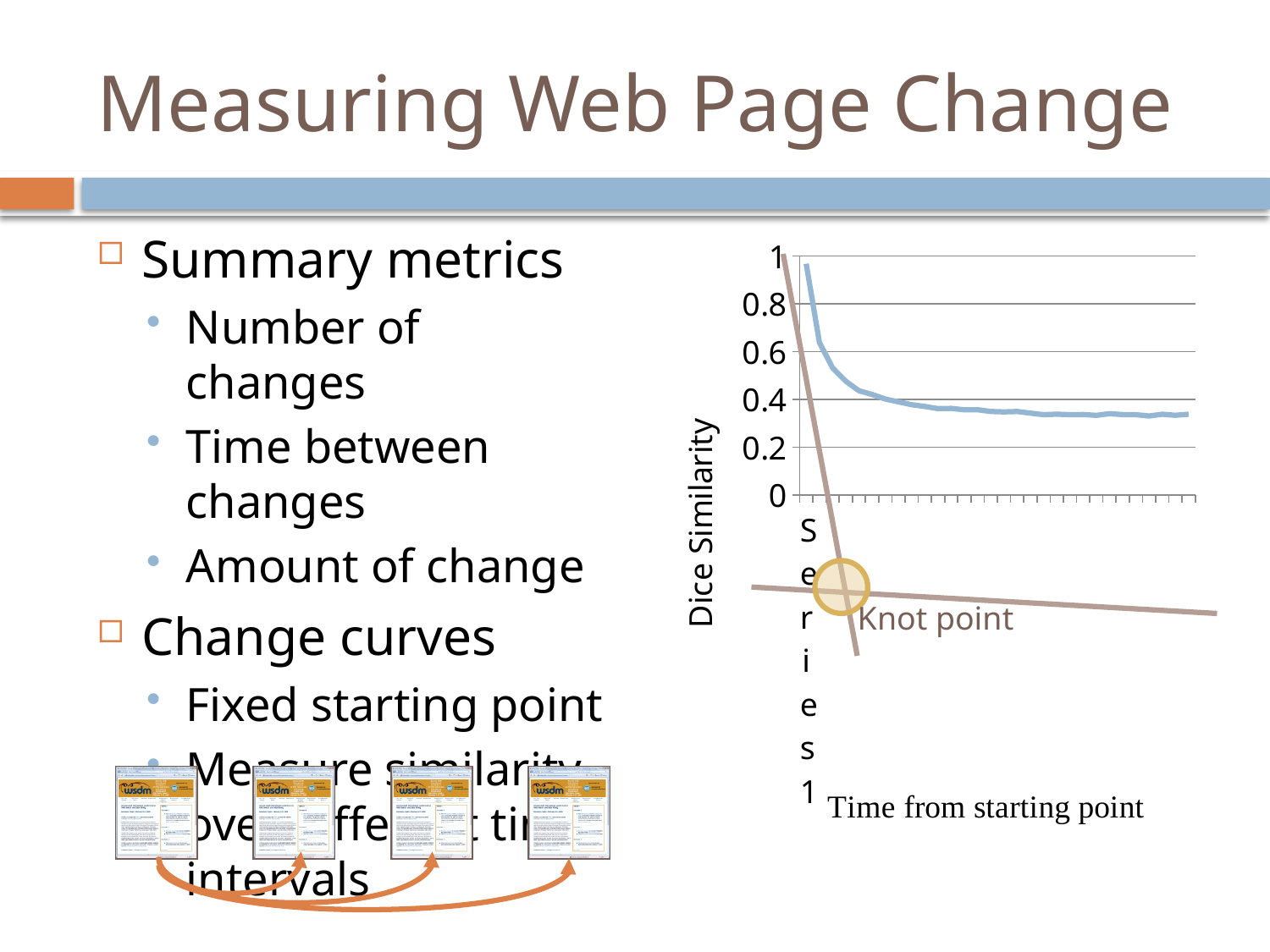
What kind of chart is shown on the slide? line chart Do the values of the line rise or fall as time from the starting point increases? fall What is the label on the x axis of the chart? Time from starting point What is the label on the y axis of the chart? Dice Similarity Is the value of the line at the right end of the chart greater or less than 0.4? less How many data series are plotted in the chart? 1 Is the value of the line at the start of the curve larger or smaller than its value at the right end of the chart? larger Is the value of the line at the right end of the chart greater or less than 0.2? greater What is the highest tick value shown on the y axis of the chart? 1 Is the value of the line at the start of the curve greater or less than 0.8? greater